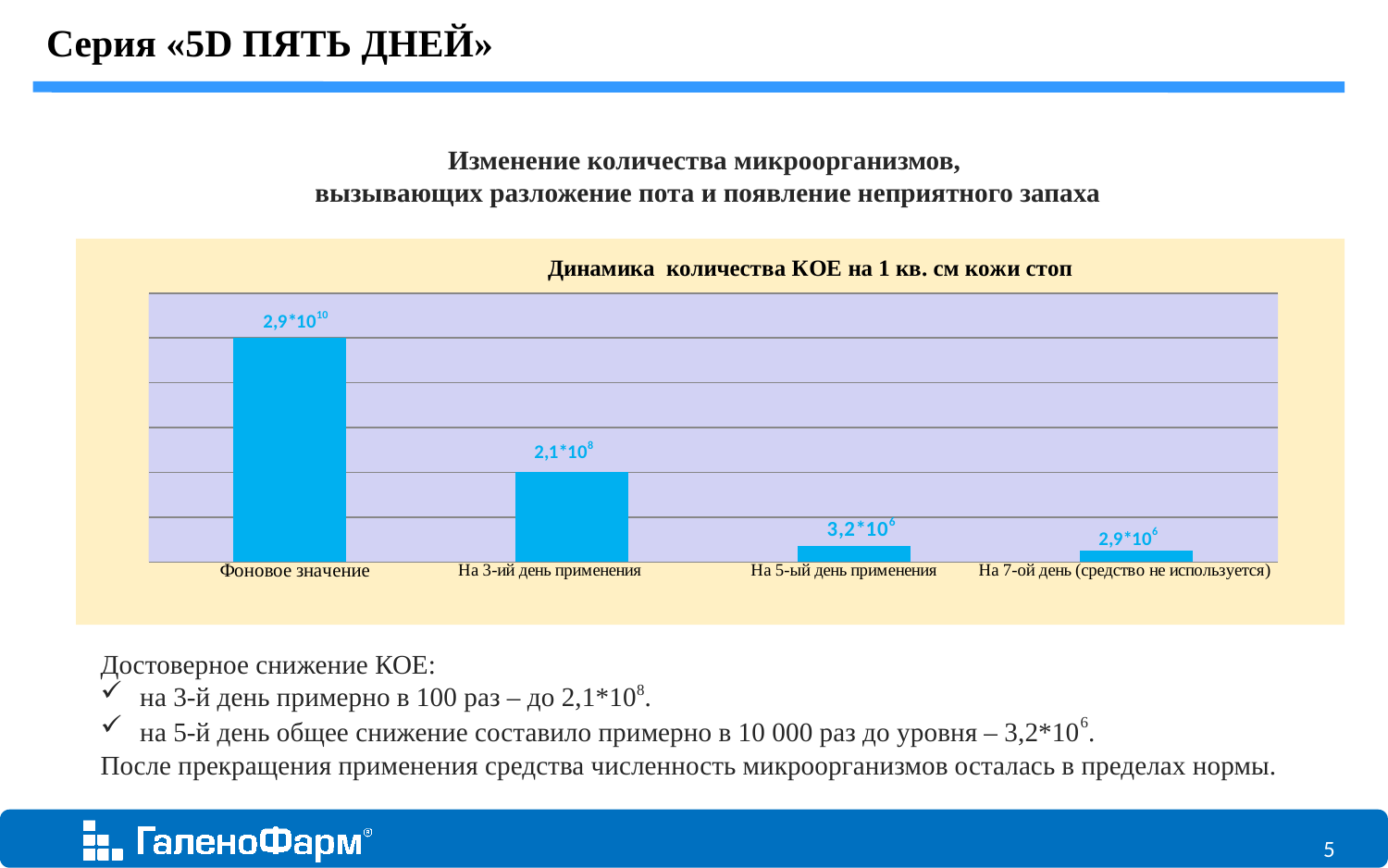
Which is larger: the value for «Фоновое значение» or for «На 3-ий день применения»? Фоновое значение What is the value for «На 7-ой день (средство не используется)»? 2,9*10⁶ What is the value for «Фоновое значение»? 2,9*10¹⁰ Which category has the highest value? Фоновое значение What is the value for «На 5-ый день применения»? 3,2*10⁶ What is the value for «На 3-ий день применения»? 2,1*10⁸ Which category has the lowest value? На 7-ой день (средство не используется) What is the title of the chart? Динамика количества КОЕ на 1 кв. см кожи стоп Which is larger: the value for «На 5-ый день применения» or for «На 7-ой день (средство не используется)»? На 5-ый день применения Do the values rise or fall from left to right along the x axis? Fall What type of chart is shown on the slide? Bar chart How many categories are plotted in the chart? 4